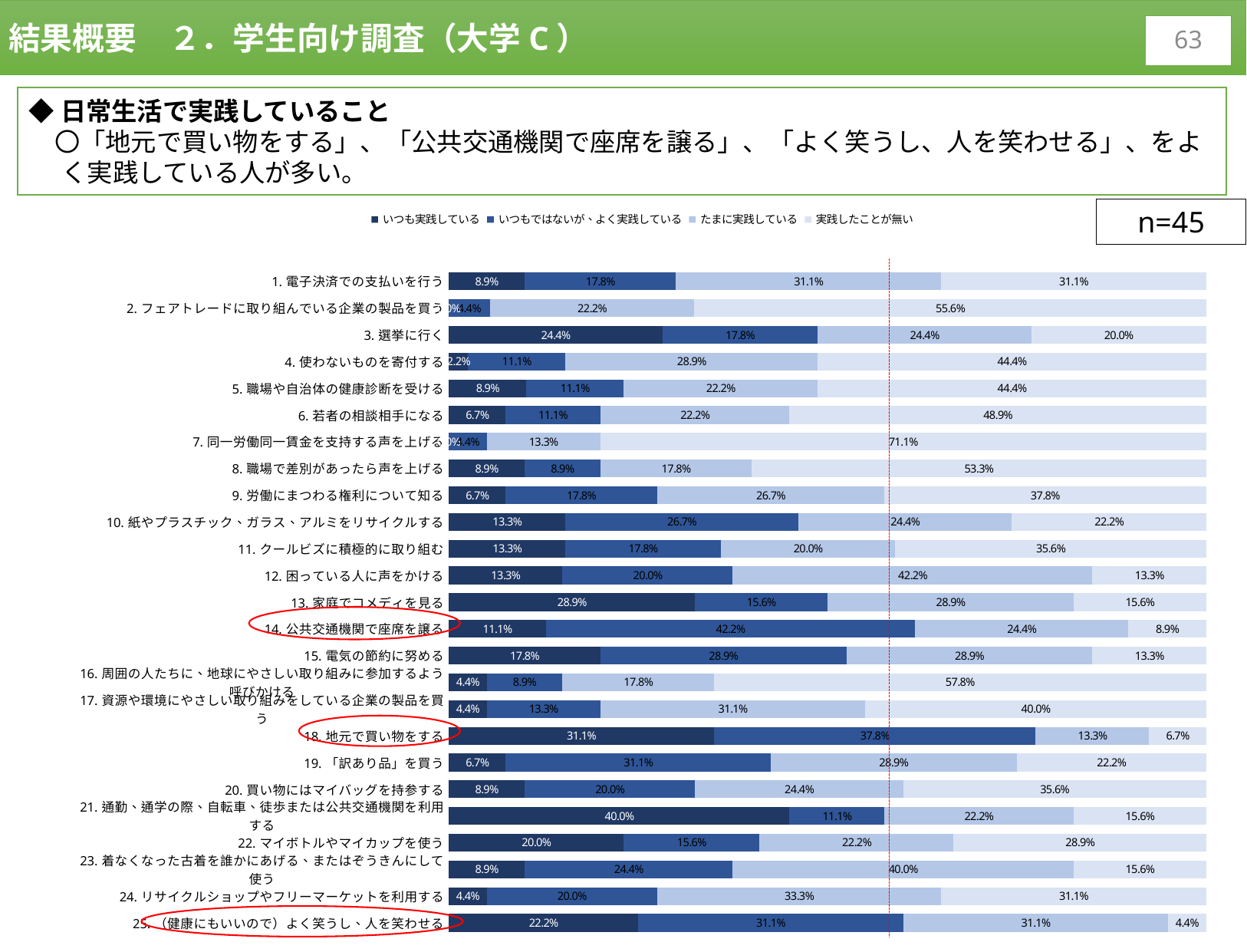
What is the sample size (n) shown on the slide? n=45 How many categories (items) are plotted in the chart? 25 Which is larger: the 「いつも実践している」 value for item 18 (地元で買い物をする) or for item 13 (家庭でコメディを見る)? 18. 地元で買い物をする Which item has the lowest value for 「実践したことが無い」? 25. （健康にもいいので）よく笑うし、人を笑わせる What is the value of 「実践したことが無い」 for item 7 (同一労働同一賃金を支持する声を上げる)? 71.1% What is the value of 「いつも実践している」 for item 21 (通勤、通学の際、自転車、徒歩または公共交通機関を利用する)? 40.0% What type of chart is shown on the slide? Stacked bar chart What is the value of 「たまに実践している」 for item 12 (困っている人に声をかける)? 42.2% How many series does the legend list? 4 What is the value of 「いつもではないが、よく実践している」 for item 14 (公共交通機関で座席を譲る)? 42.2% Which item has the highest value for 「いつも実践している」? 21. 通勤、通学の際、自転車、徒歩または公共交通機関を利用する For item 1 (電子決済での支払いを行う), what is the difference between 「実践したことが無い」 (31.1%) and 「いつも実践している」 (8.9%)? 22.2%